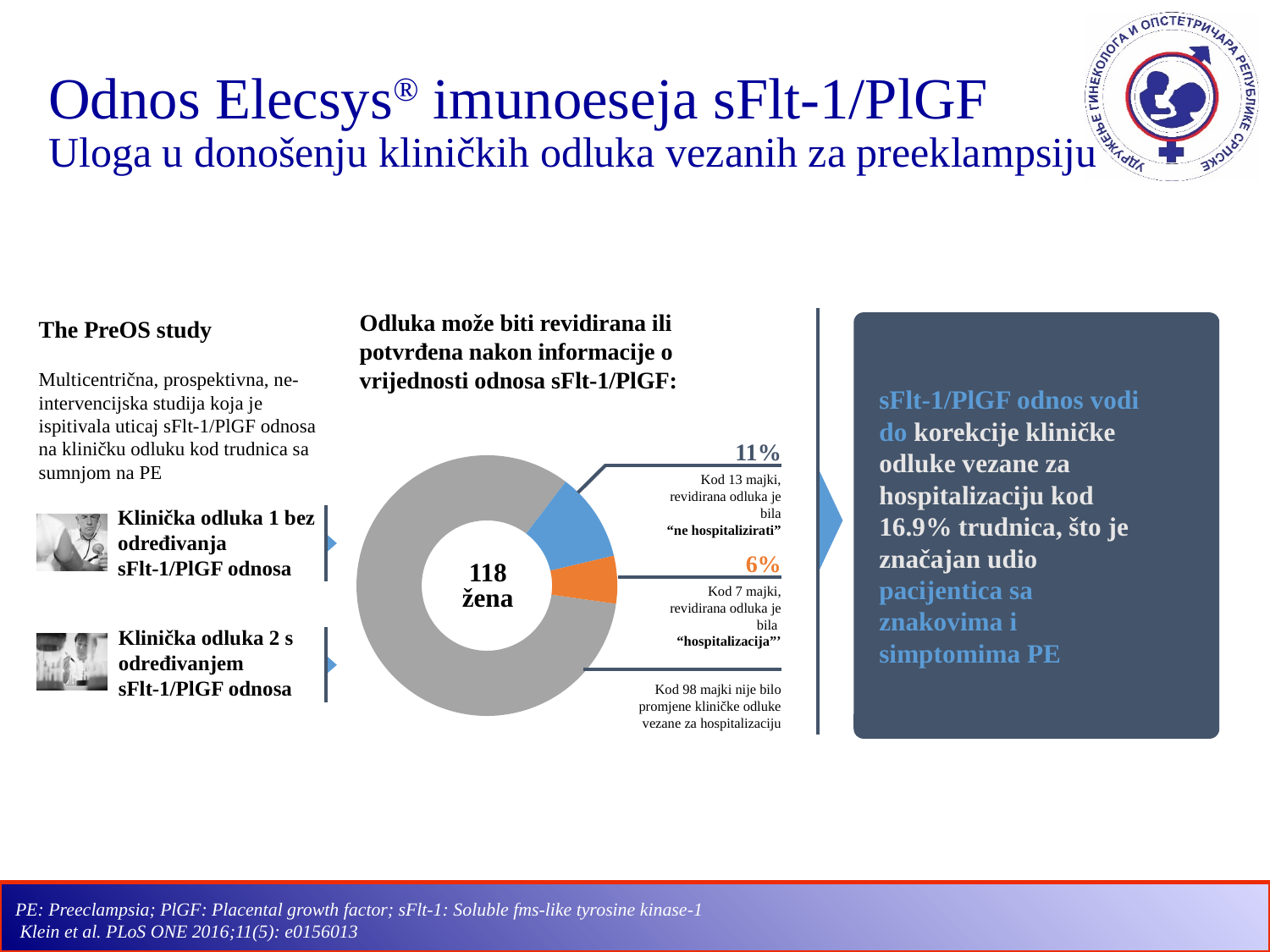
Which slice of the donut chart is the largest? the grey slice (98 mothers, no change in decision) According to the chart labels, for how many mothers was the decision revised to "ne hospitalizirati"? 13 According to the chart labels, for how many mothers was the decision revised to "hospitalizacija"? 7 According to the chart labels, for how many mothers was there no change in the clinical decision about hospitalisation? 98 What percentage is shown for the slice labelled "ne hospitalizirati"? 11% What percentage is shown for the slice labelled "hospitalizacija"? 6% What number is printed in the centre of the donut chart? 118 žena What kind of chart is shown in the middle of the slide? donut (pie) chart Which slice of the donut chart is the smallest? the orange slice ("hospitalizacija", 6%) How many slices does the donut chart have? 3 What colour is the slice representing the 11% share? blue How many more mothers had their decision revised to "ne hospitalizirati" than to "hospitalizacija"? 6